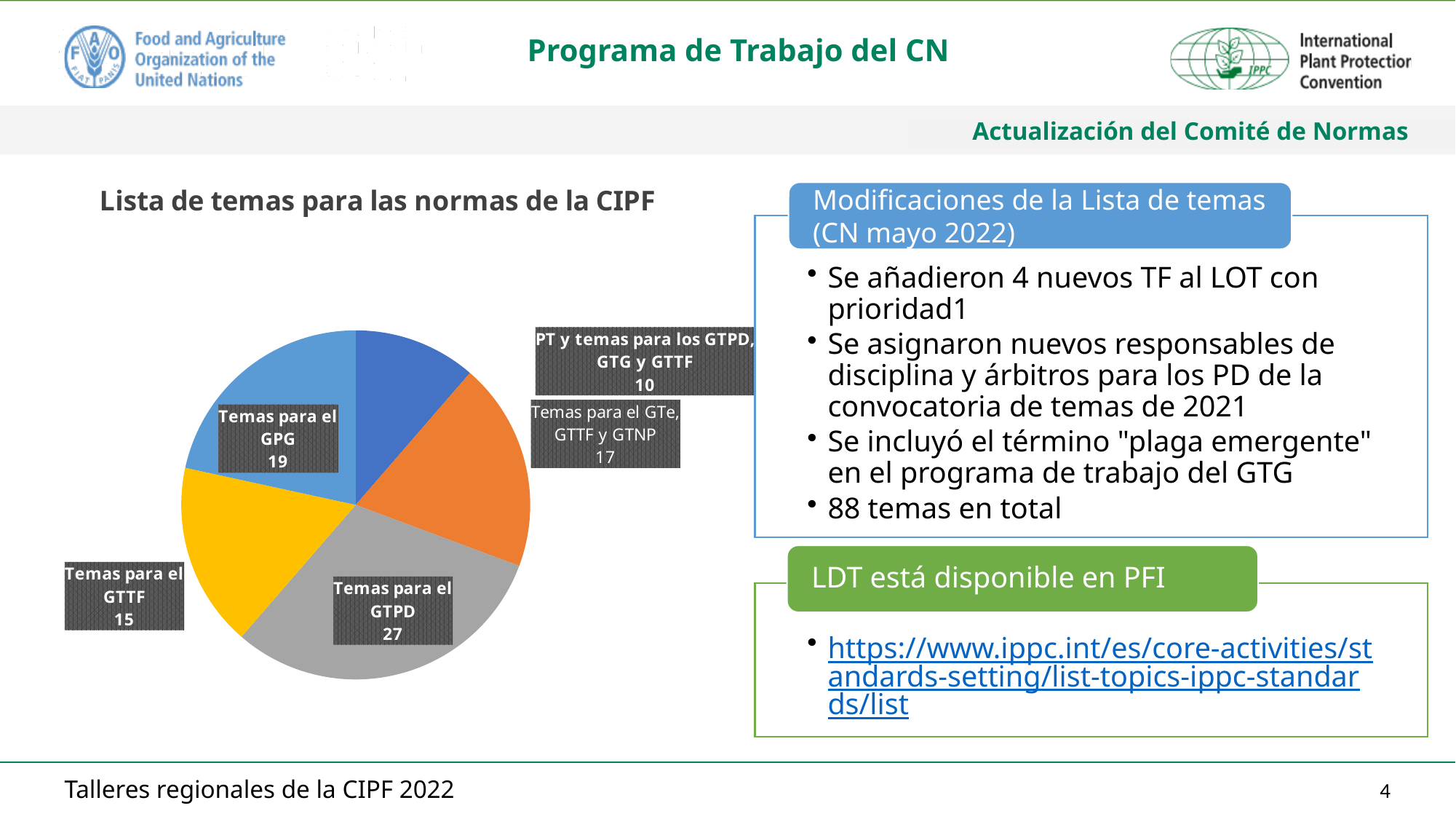
Which is larger in the pie chart: 'Temas para el GPG' or 'Temas para el GTe, GTTF y GTNP'? Temas para el GPG Which category has the largest slice in the pie chart? Temas para el GTPD What is the value for 'Temas para el GTe, GTTF y GTNP' in the pie chart? 17 What is the total of all the values shown in the pie chart? 88 What is the value for 'Temas para el GPG' in the pie chart? 19 What is the title of the pie chart on the slide? Lista de temas para las normas de la CIPF Which category has the smallest slice in the pie chart? PT y temas para los GTPD, GTG y GTTF How many slices does the pie chart 'Lista de temas para las normas de la CIPF' have? 5 What is the difference between the values for 'Temas para el GTPD' and 'Temas para el GTTF' in the pie chart? 12 What is the value for 'Temas para el GTPD' in the pie chart? 27 What type of chart is shown under the title 'Lista de temas para las normas de la CIPF'? Pie chart What is the value for 'PT y temas para los GTPD, GTG y GTTF' in the pie chart? 10